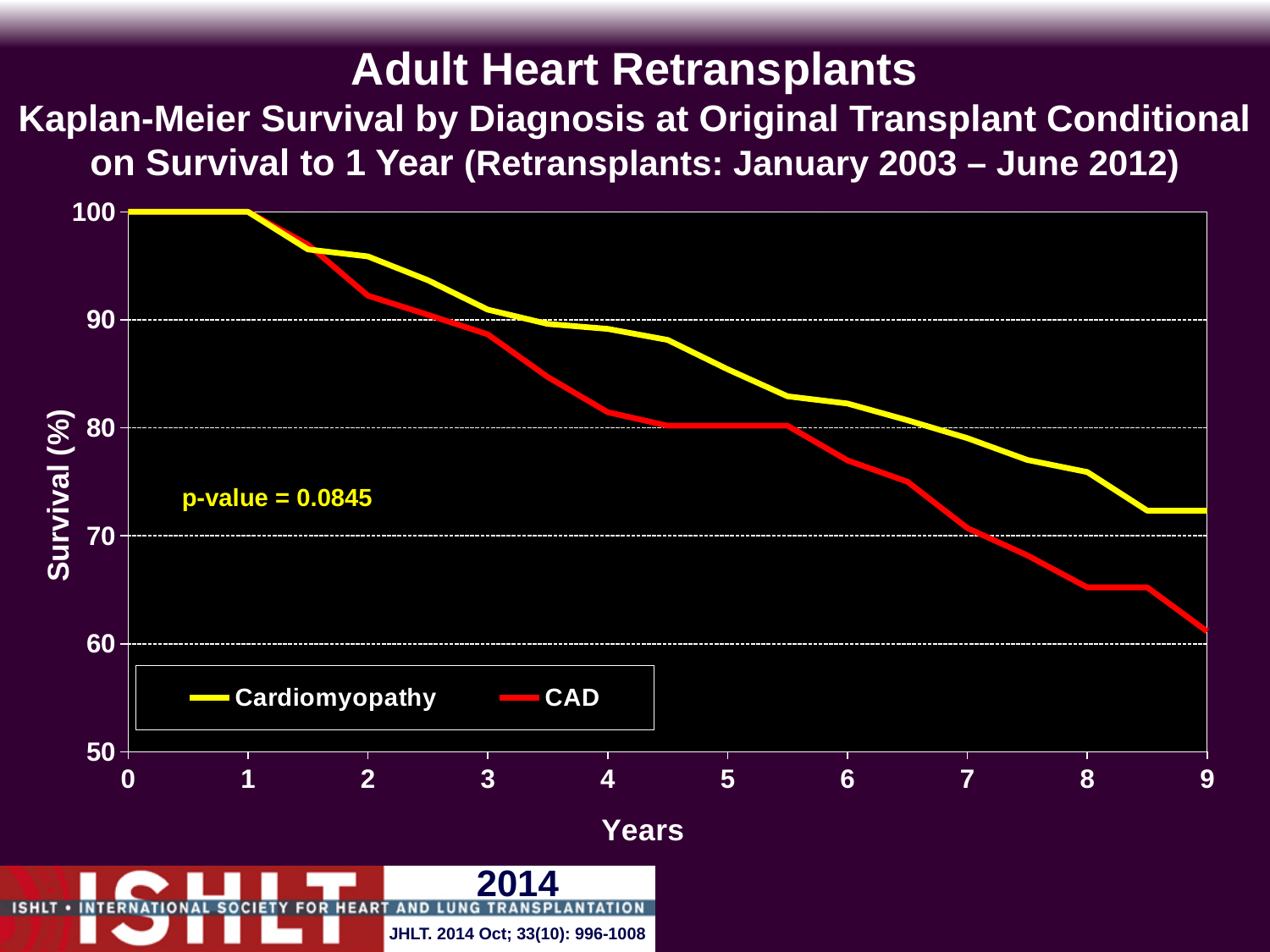
Is the survival value for Cardiomyopathy at year 9 greater or less than 70? greater What is the survival value for CAD at year 1? 100 Is the survival value for CAD at year 8 greater or less than 70? less What is the survival value for Cardiomyopathy at year 0? 100 Do the survival values for CAD rise or fall as years increase? fall Is the survival value for CAD at year 9 greater or less than 70? less What kind of chart is shown on the slide? line chart At year 9, which series has the higher survival value, Cardiomyopathy or CAD? Cardiomyopathy What p-value is printed on the chart? 0.0845 How many series does the legend list? 2 Which two diagnosis groups are plotted in the chart? Cardiomyopathy and CAD